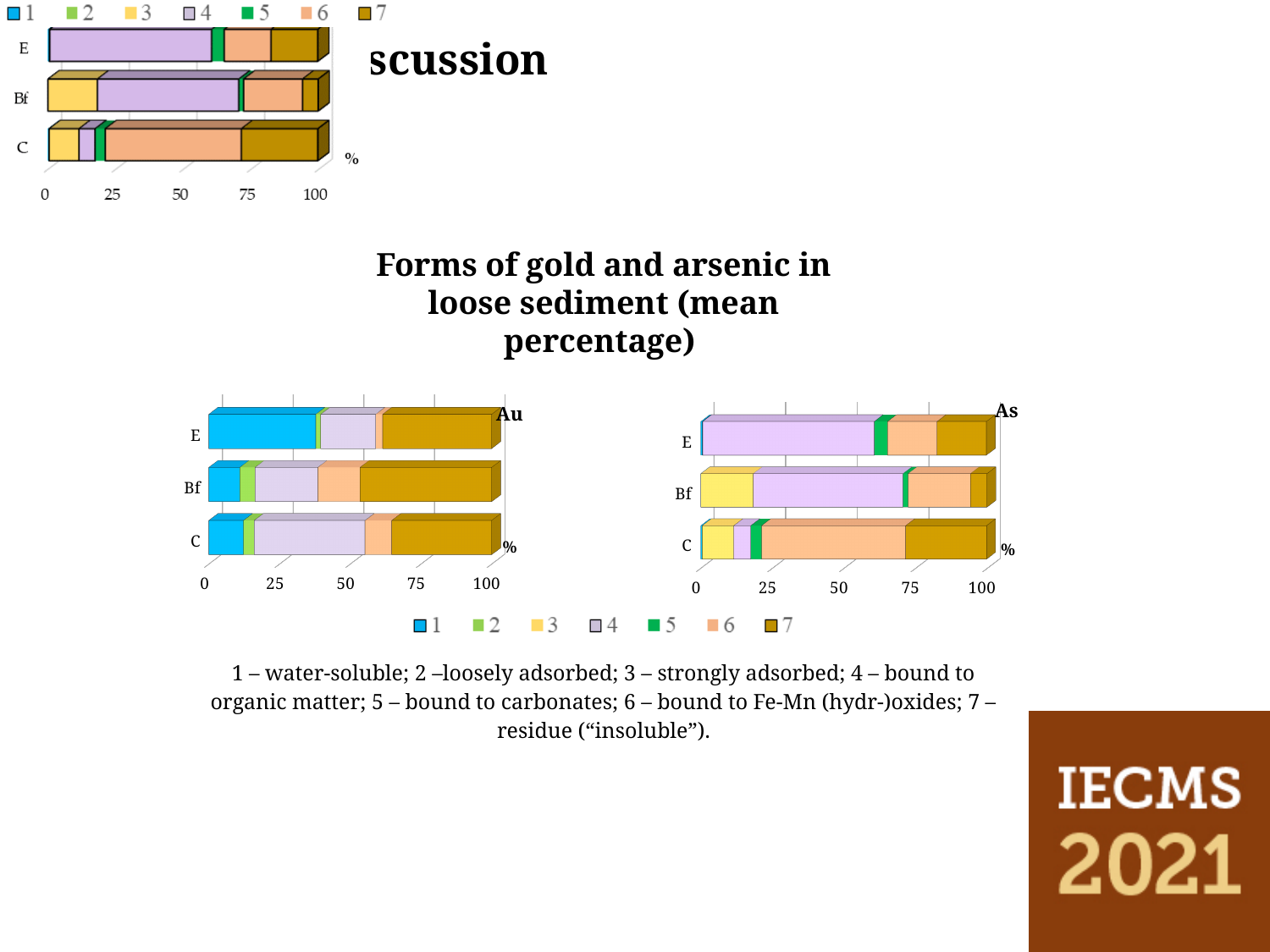
In the Au chart, is the value of series 1 for category E greater or less than 25? greater In the As chart, is the value of series 4 for category E greater or less than 50? greater In the Au chart, is the value of series 1 for category Bf greater or less than 25? less In the As chart, which category has the larger value for series 4, E or C? E What kind of chart is the Au chart? stacked bar chart How many categories are shown on the y axis of the As chart? 3 What is the title above the Au and As charts? Forms of gold and arsenic in loose sediment (mean percentage) In the Au chart, which category has the larger value for series 1, E or Bf? E How many series does the legend below the Au and As charts list? 7